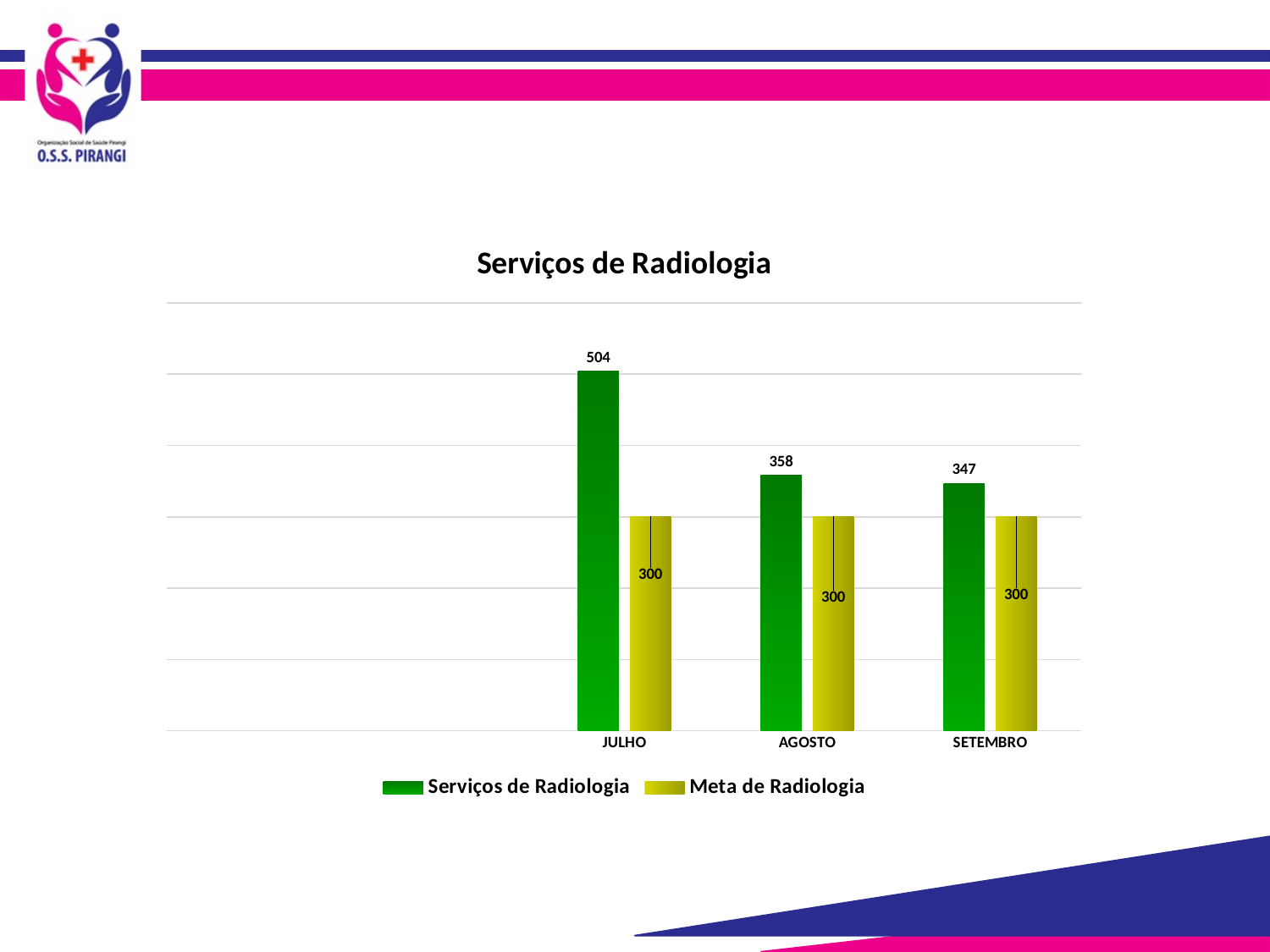
What is the difference between the Serviços de Radiologia values for AGOSTO and SETEMBRO? 11 What is the difference between the Serviços de Radiologia value for JULHO and the Meta de Radiologia for JULHO? 204 What is the value of Serviços de Radiologia for AGOSTO? 358 How many months are shown on the x axis? 3 What is the value of Serviços de Radiologia for JULHO? 504 How many series does the legend list? 2 What is the Meta de Radiologia value for AGOSTO? 300 Which month has the lowest Serviços de Radiologia value? SETEMBRO Which month has the highest Serviços de Radiologia value? JULHO What is the value of Serviços de Radiologia for SETEMBRO? 347 Which is larger: Serviços de Radiologia for SETEMBRO or Meta de Radiologia for SETEMBRO? Serviços de Radiologia for SETEMBRO What kind of chart is shown on the slide? Bar chart